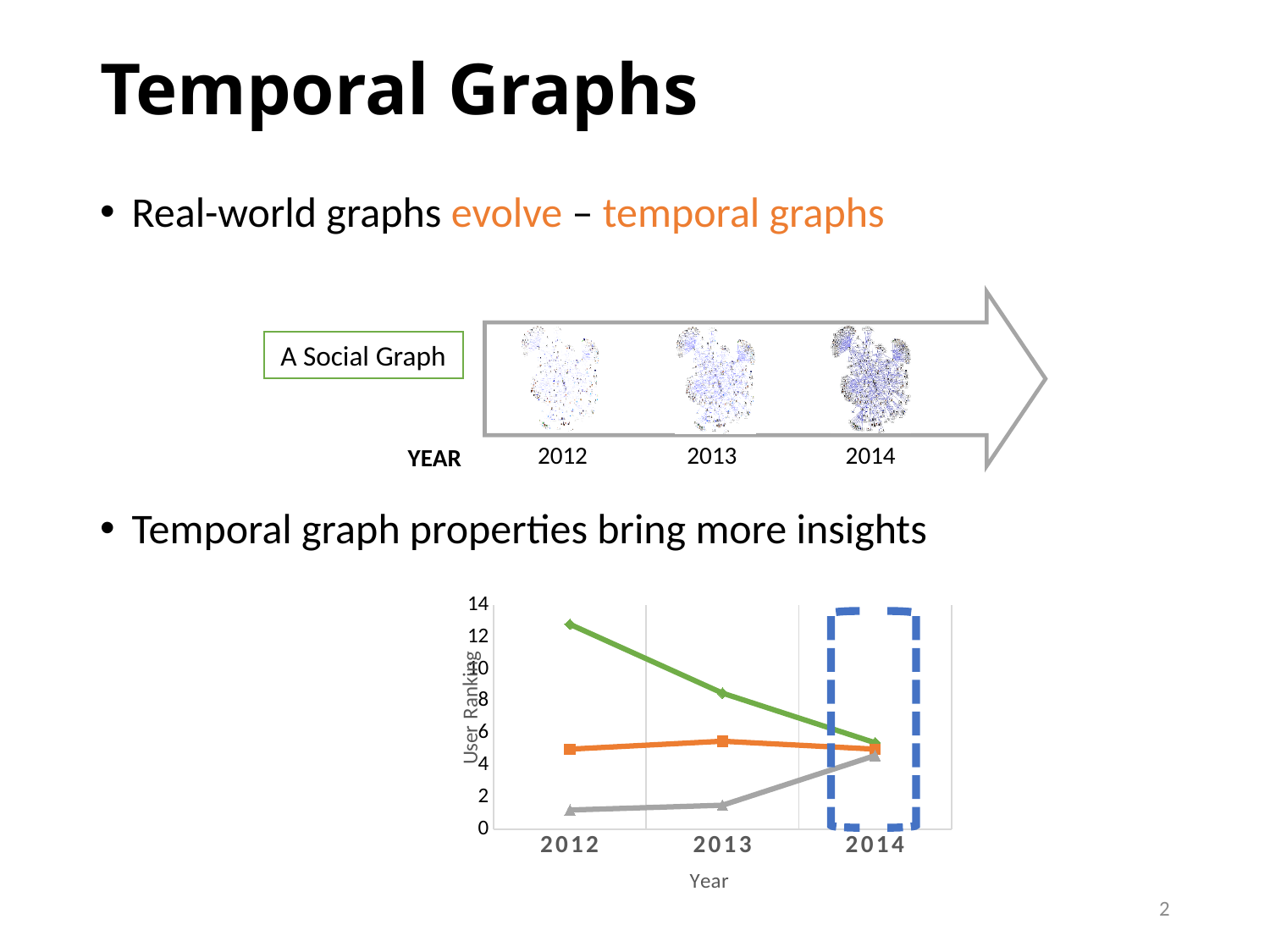
How many years are shown on the x axis of the line chart? 3 Does the gray line rise or fall from 2012 to 2014? rise What is the label of the y axis of the line chart? User Ranking What kind of chart is shown at the bottom of the slide? line chart Which line has the lowest value in 2012? the gray line Is the value of the green line in 2013 greater or less than 8? greater In 2013, which is larger: the value of the orange line or the value of the gray line? the orange line Which line has the highest value in 2012? the green line Is the value of the gray line in 2013 greater or less than 2? less Is the value of the green line in 2012 greater or less than 12? greater What is the label of the x axis of the line chart? Year Does the green line rise or fall from 2012 to 2014? fall